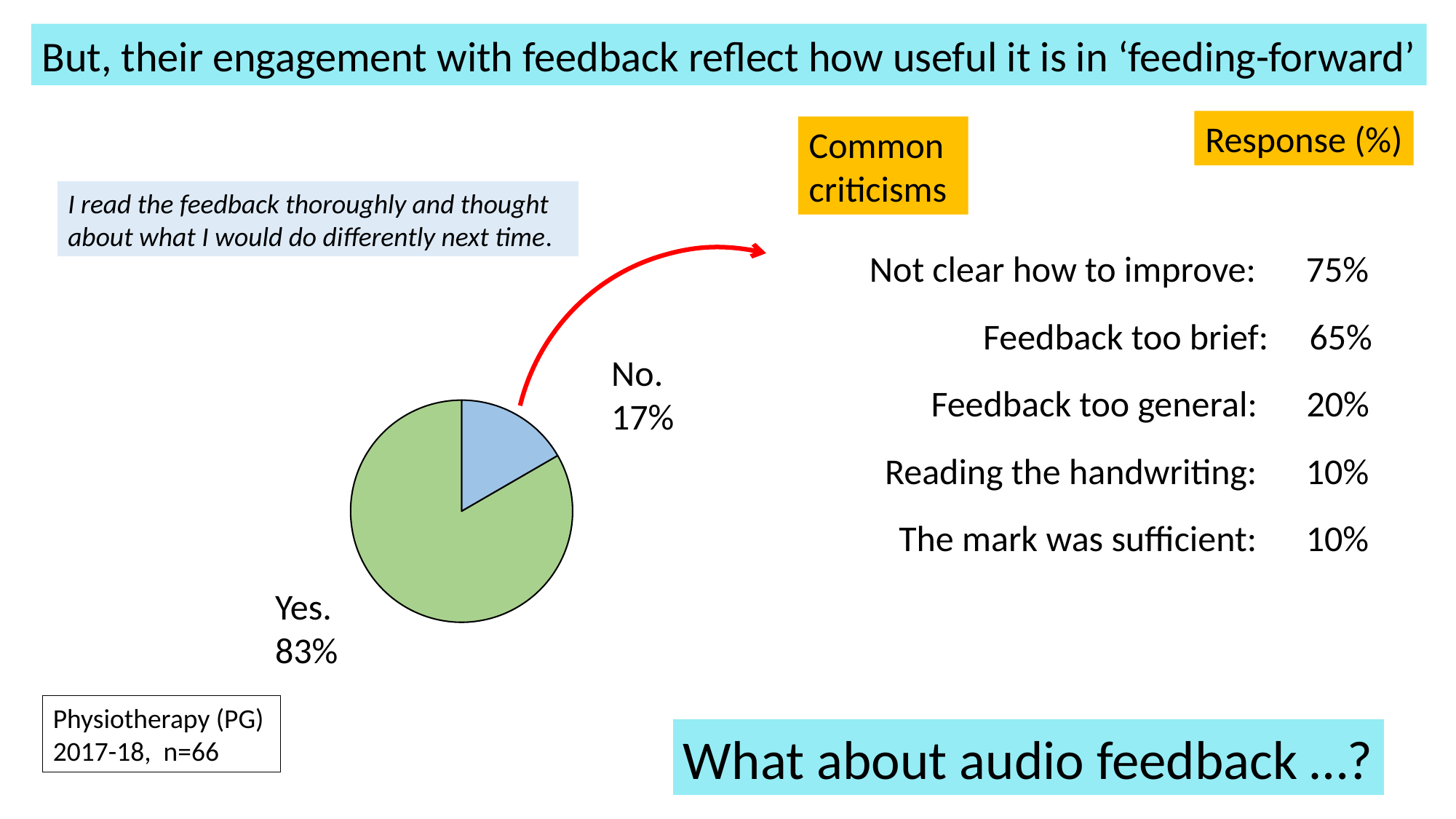
How many slices does the pie chart have? 2 What colour is the "Yes" slice of the pie chart? green Which slice of the pie chart is the smallest? No What share of the pie does the "No" slice represent? 17% What percentage of the pie chart is labelled "Yes"? 83% What kind of chart is shown on the slide? pie chart What percentage of the pie chart is labelled "No"? 17% Which is larger in the pie chart, the "Yes" slice or the "No" slice? Yes What colour is the "No" slice of the pie chart? blue Which slice of the pie chart is the largest? Yes What is the difference in percentage points between the "Yes" and "No" slices of the pie chart? 66